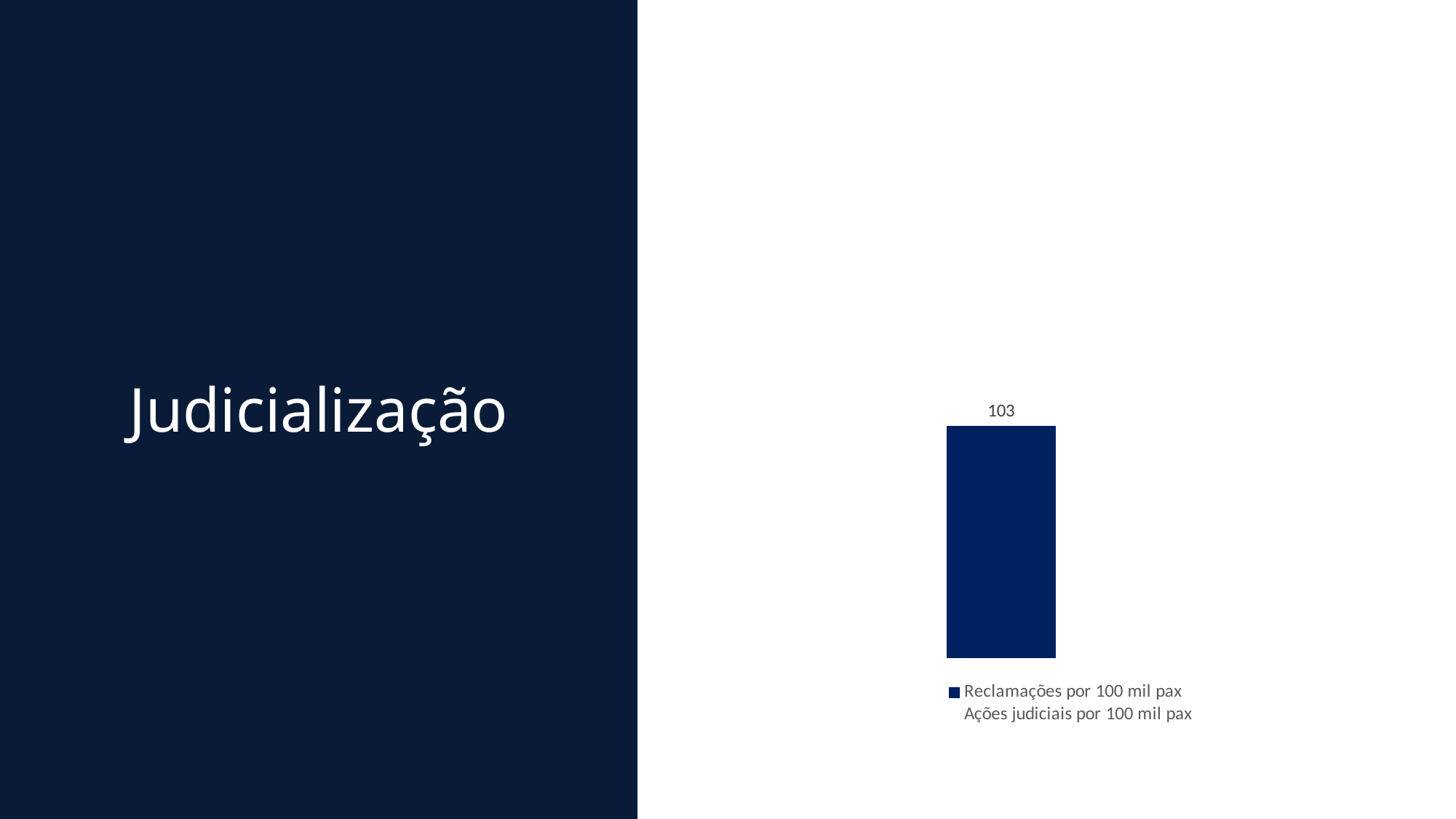
What value is shown on the bar for Reclamações por 100 mil pax? 103 How many bars are visible in the chart? 1 What is the second entry in the chart's legend? Ações judiciais por 100 mil pax What kind of chart is shown on the slide? bar chart How many series does the chart's legend list? 2 Is the value labelled on the visible bar greater or less than 100? greater What is the first entry in the chart's legend? Reclamações por 100 mil pax